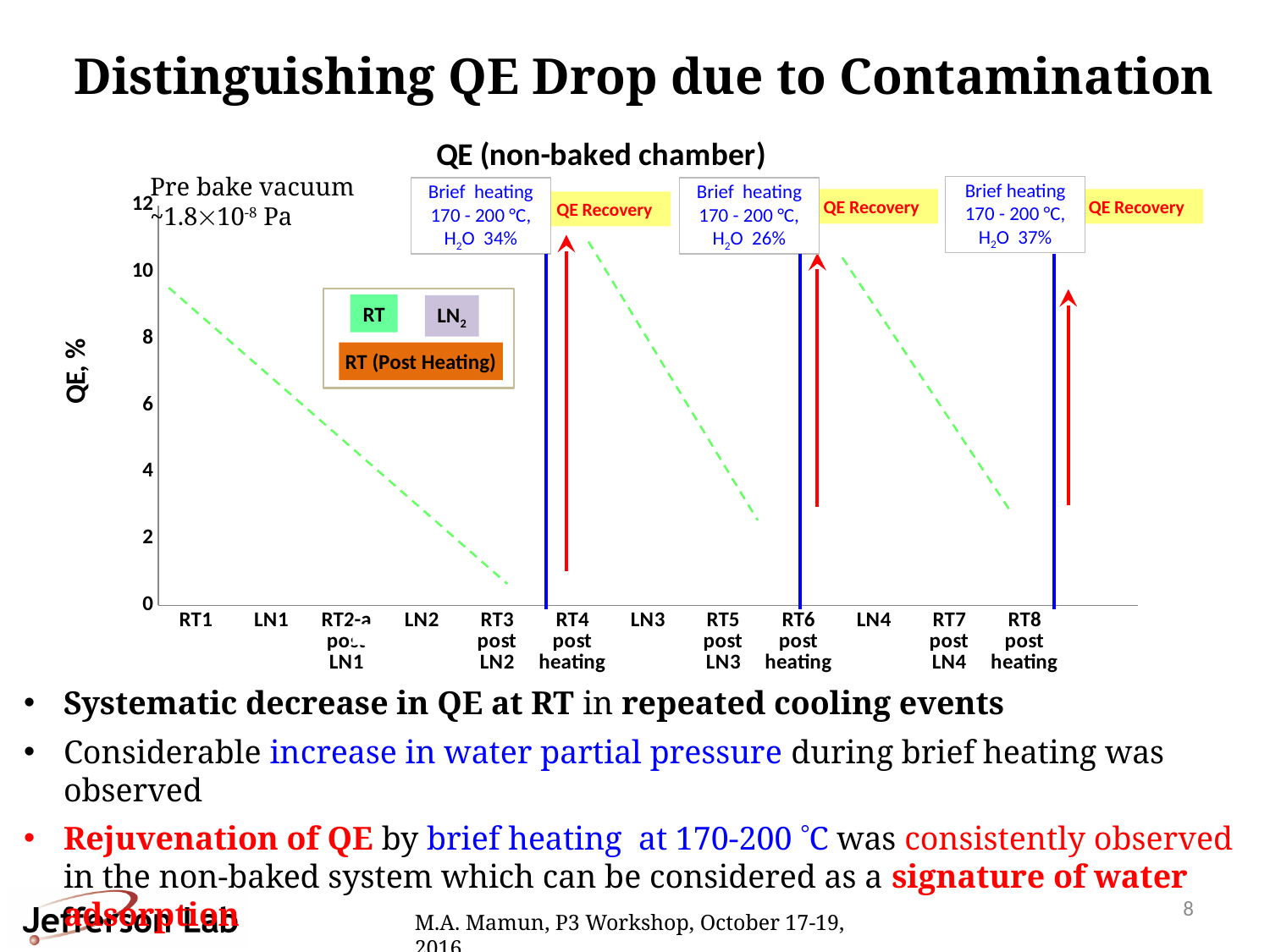
How many entries does the chart's legend list? 3 What is the highest tick value shown on the y axis of the chart? 12 What is the title of the chart? QE (non-baked chamber) What is the label on the y axis of the chart? QE, % How many 'QE Recovery' labels appear on the chart? 3 How many categories are labelled along the x axis of the chart? 12 What H2O value is given in the second 'Brief heating 170 - 200 °C' annotation box on the chart? 26% What H2O value is given in the first 'Brief heating 170 - 200 °C' annotation box on the chart? 34% Does the dashed green line between RT4 post heating and RT5 post LN3 rise or fall along the x axis? fall What H2O value is given in the third 'Brief heating 170 - 200 °C' annotation box on the chart? 37% Which of the three brief heating annotation boxes on the chart shows the highest H2O value? the third (37%) Does the dashed green line between RT1 and RT3 post LN2 rise or fall along the x axis? fall